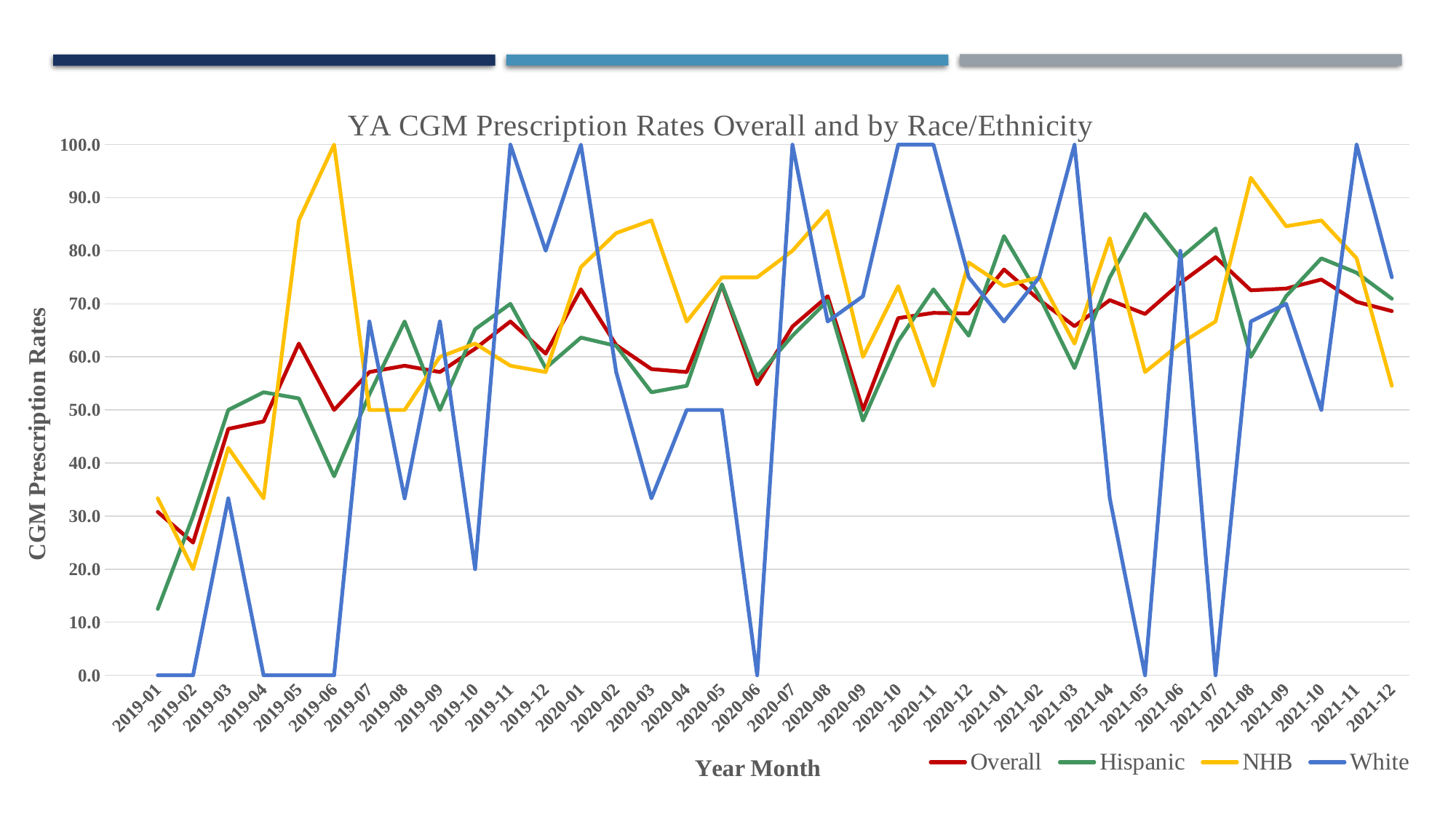
Does the Overall series generally rise or fall from 2019-01 to 2021-12? rise What is the title of the chart? YA CGM Prescription Rates Overall and by Race/Ethnicity How many series does the legend list? 4 Which series has the higher value in 2019-05, NHB or Hispanic? NHB What is the value for NHB in 2019-06? 100.0 How many months are plotted along the x axis? 36 What is the value for White in 2020-06? 0.0 What is the value for White in 2019-11? 100.0 What is the value for White in 2019-01? 0.0 Is the value for Hispanic in 2021-05 greater or less than 80.0? greater What type of chart is shown on the slide? line chart Is the value for Overall in 2019-02 greater or less than 30.0? less